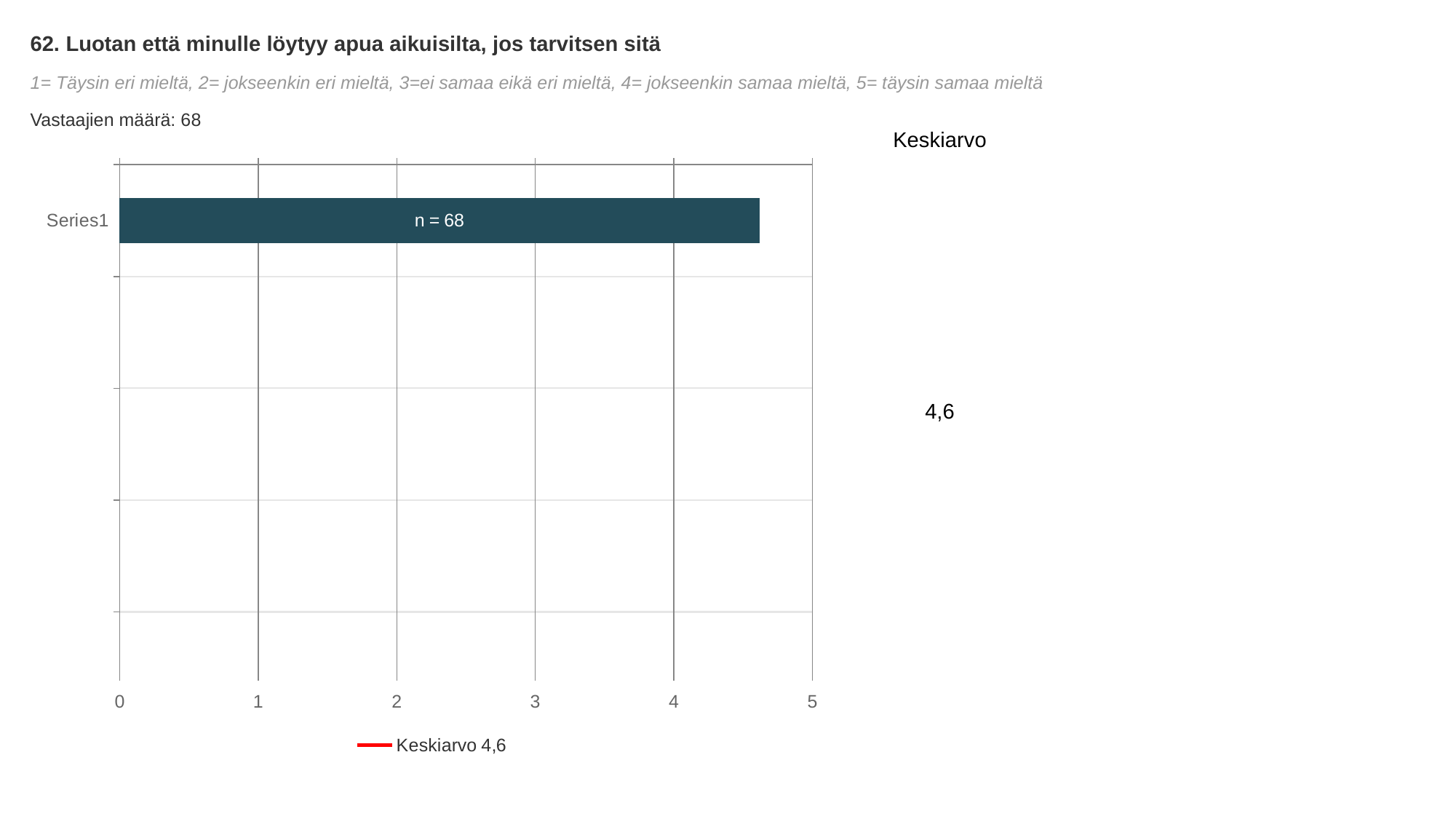
Is the value for Series1 greater or less than 4? greater How many bars are plotted in the chart? 1 What does the legend entry below the chart say? Keskiarvo 4,6 What is the category label of the single bar in the chart? Series1 How many respondents (Vastaajien määrä) are reported on the slide? 68 Is the value for Series1 greater or less than 5? less What is the Keskiarvo (mean) value shown on the slide? 4,6 What is the maximum value shown on the x axis? 5 What kind of chart is shown on the slide? bar chart What data label is printed on the Series1 bar? n = 68